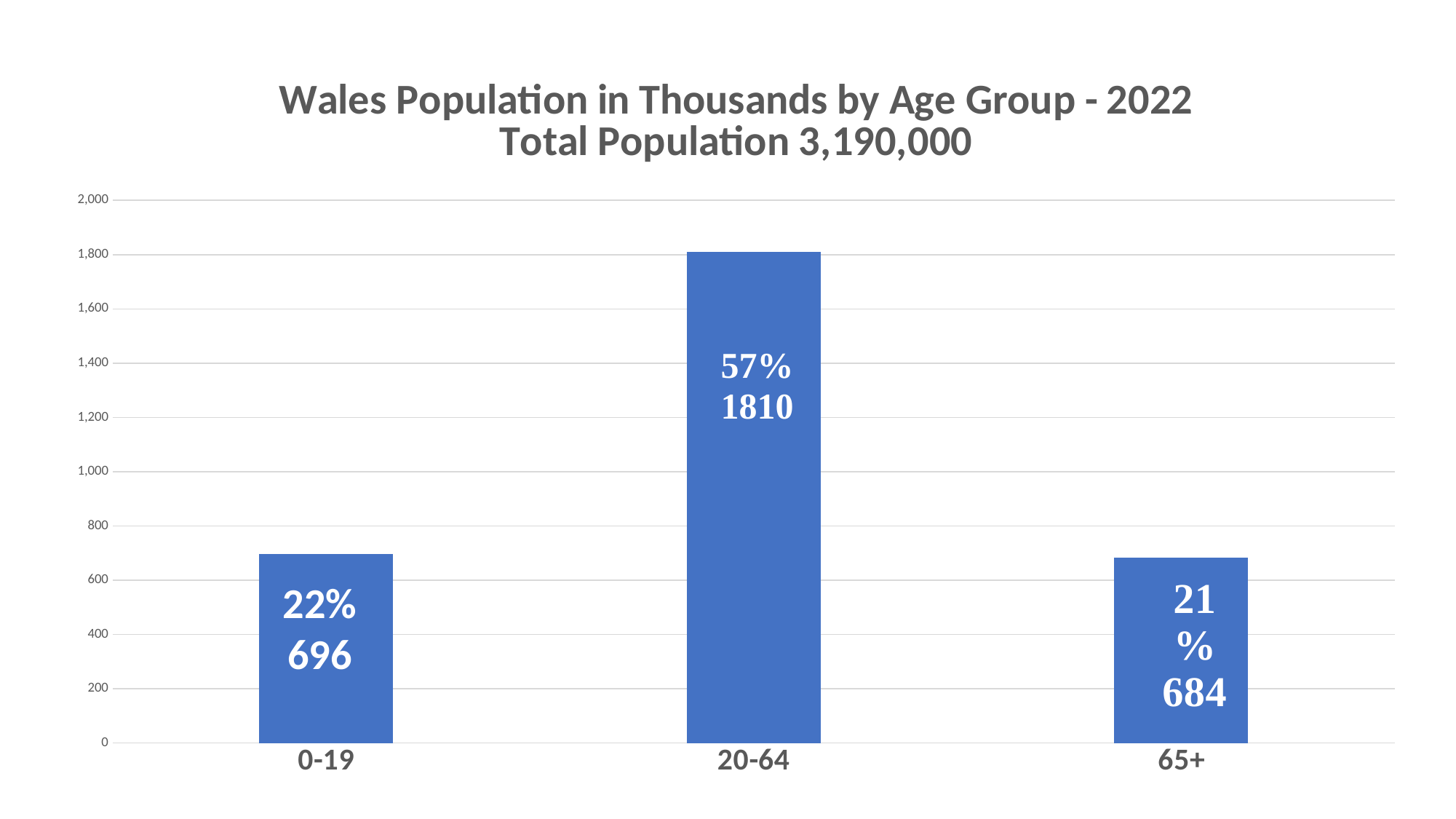
What is the difference between the population values for the 0-19 and 65+ age groups? 12 What is the population value shown for the 20-64 age group? 1810 Which has a larger population, the 0-19 age group or the 20-64 age group? 20-64 What is the population value shown for the 65+ age group? 684 What percentage is shown on the bar for the 65+ age group? 21% Which age group has the lowest population? 65+ What percentage is shown on the bar for the 20-64 age group? 57% What type of chart is shown on the slide? Bar chart What is the population value shown for the 0-19 age group? 696 What is the difference between the population values for the 20-64 and 0-19 age groups? 1114 Which age group has the highest population? 20-64 How many age groups are shown in the chart? 3